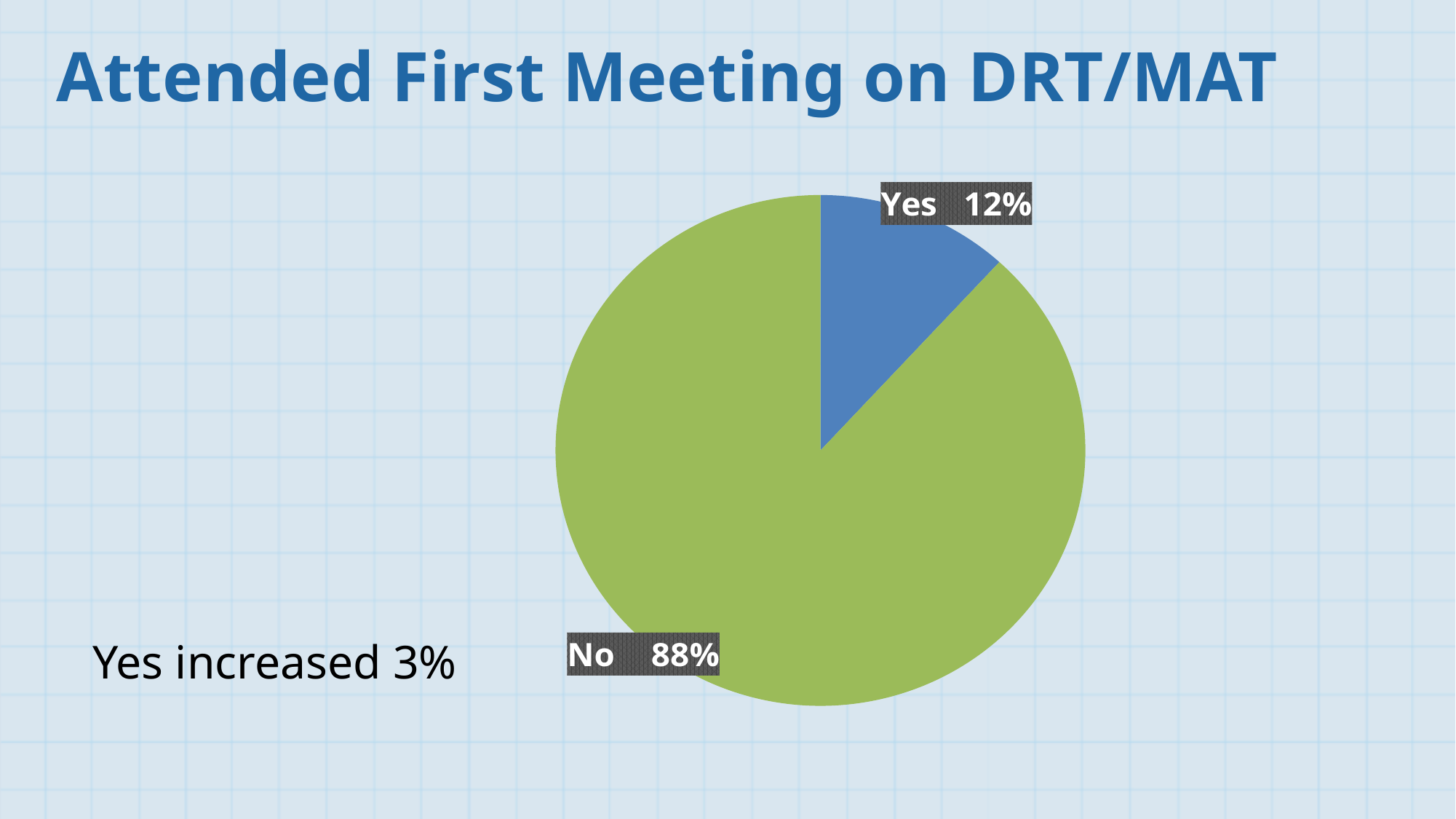
How many slices does the pie chart have? 2 Which slice is the largest? No What colour is the "Yes" slice? blue What share of the pie does the "No" slice represent? 88% Which slice is the smallest? Yes Which slice is larger, "Yes" or "No"? No What percentage of the pie is labelled "Yes"? 12% What kind of chart is shown on the slide? pie chart What is the title of the chart? Attended First Meeting on DRT/MAT What percentage of the pie is labelled "No"? 88% What is the difference in percentage points between the "No" slice and the "Yes" slice? 76